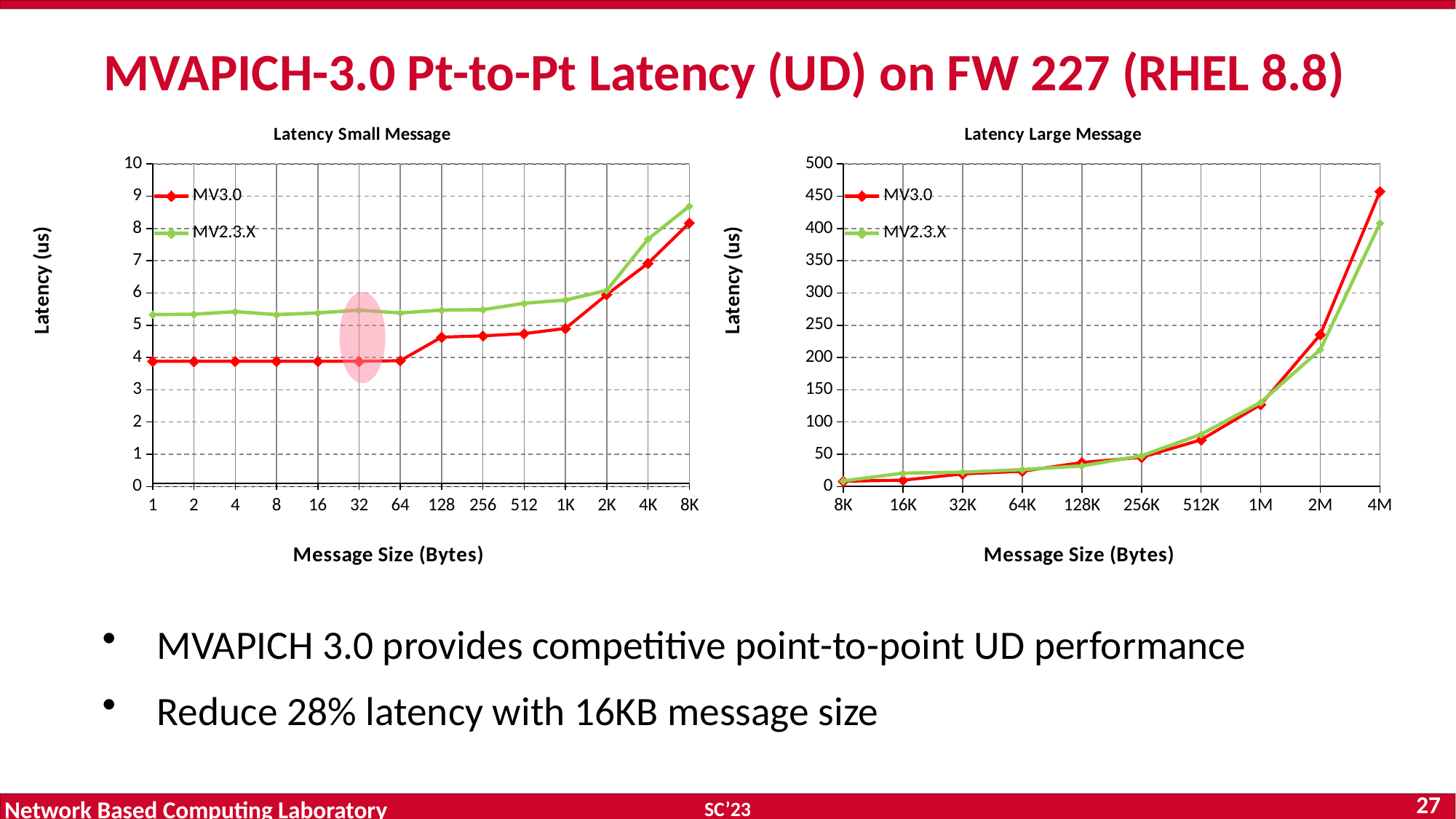
How many message sizes are plotted on the x axis of the Latency Small Message chart? 14 How many message sizes are plotted on the x axis of the Latency Large Message chart? 10 How many series does the legend of the Latency Large Message chart list? 2 In the Latency Small Message chart, at which message size does the MV3.0 series reach its highest latency? 8K In the Latency Large Message chart, do the latency values rise or fall as message size increases? rise In the Latency Small Message chart, is the MV2.3.X latency at message size 1 greater or less than 5? greater In the Latency Small Message chart, which series has the higher latency at message size 32, MV3.0 or MV2.3.X? MV2.3.X In the Latency Large Message chart, which series has the higher latency at message size 4M, MV3.0 or MV2.3.X? MV3.0 What kind of chart is the Latency Small Message chart? line chart In the Latency Large Message chart, is the MV3.0 latency at message size 2M greater or less than 200? greater In the Latency Small Message chart, is the MV3.0 latency at message size 8K greater or less than 8? greater